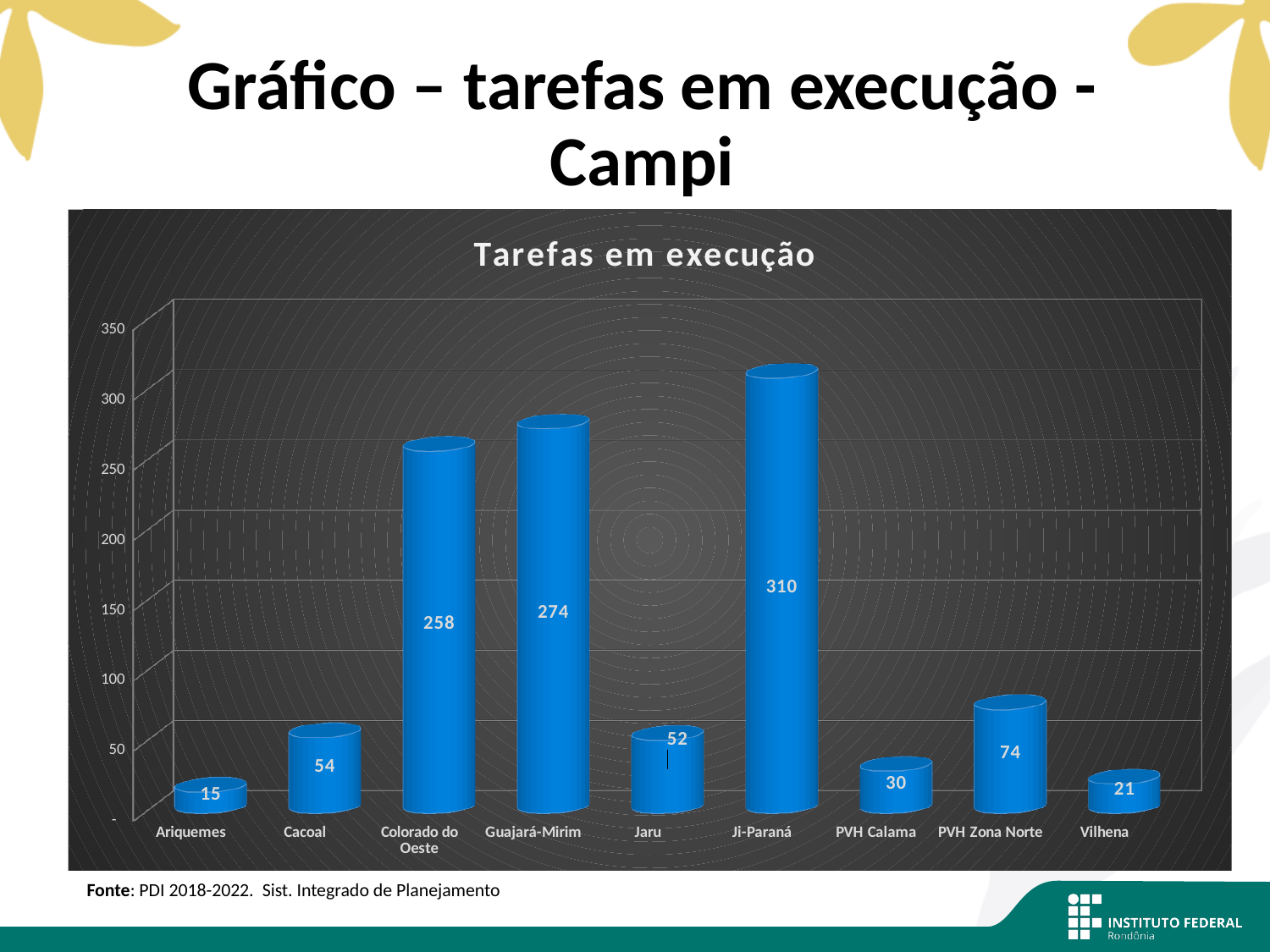
How many campi are shown on the x axis of the chart? 9 Which campus has the highest number of tarefas em execução? Ji-Paraná What is the title of the chart? Tarefas em execução Which is larger, the value for PVH Zona Norte or the value for Cacoal? PVH Zona Norte What is the value for Vilhena? 21 Which campus has the lowest number of tarefas em execução? Ariquemes What kind of chart is shown on the slide? Bar chart What is the value for Colorado do Oeste? 258 What is the difference between the values for Jaru and PVH Calama? 22 Is the value for Ji-Paraná greater or less than 300? greater What is the value for Ji-Paraná in the 'Tarefas em execução' chart? 310 What is the difference between the values for Guajará-Mirim and Colorado do Oeste? 16